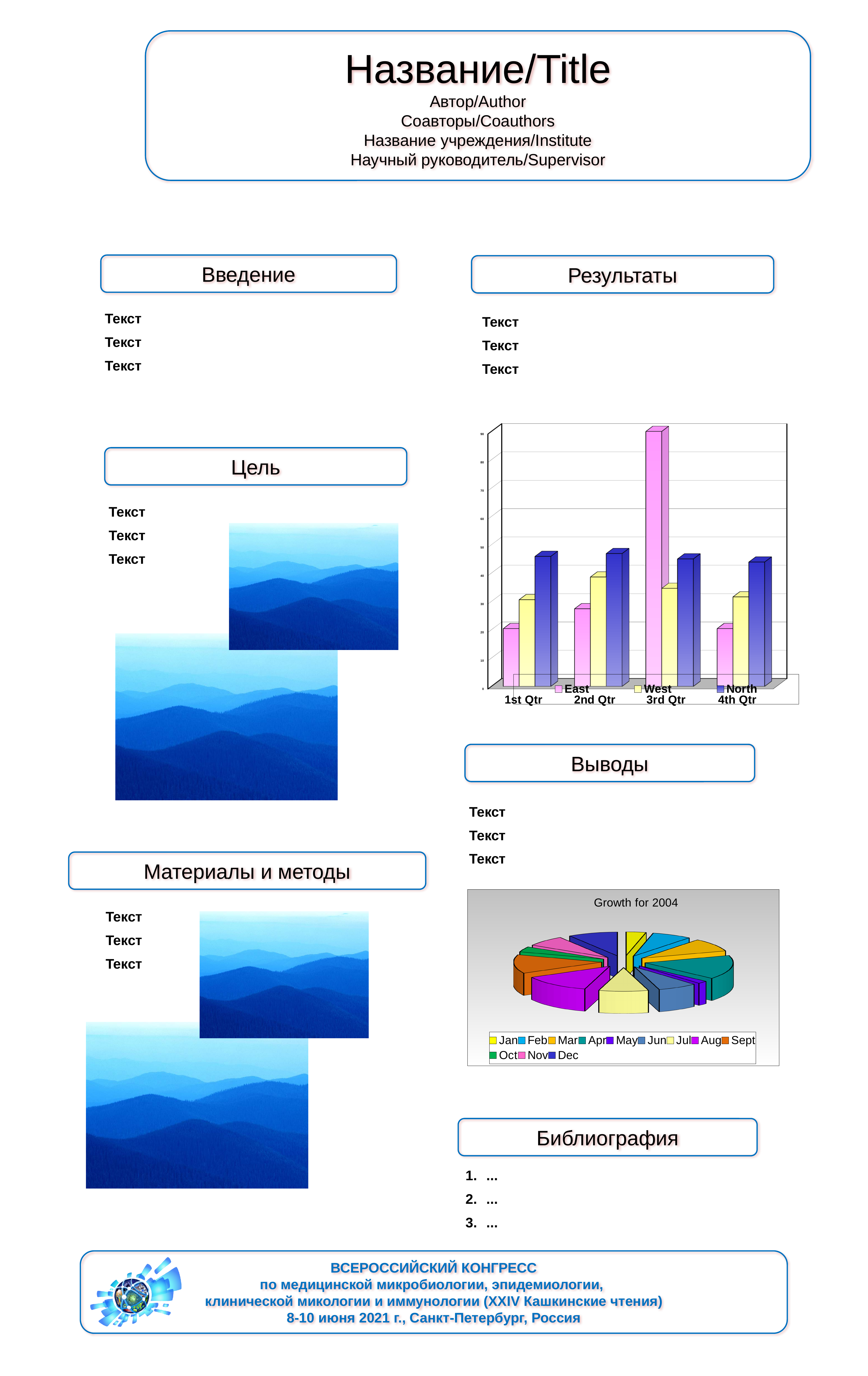
In the bar chart in the Результаты section, is the value for East in 1st Qtr greater or less than 30? less How many slices does the pie chart titled 'Growth for 2004' have? 12 In the bar chart in the Результаты section, is the value for North in 1st Qtr greater or less than 40? greater In the bar chart in the Результаты section, how many series does the legend list? 3 What is the title of the pie chart in the Выводы section? Growth for 2004 In the bar chart in the Результаты section, in which quarter is the East series highest? 3rd Qtr In the bar chart in the Результаты section, which is larger in 3rd Qtr: East or West? East What kind of chart is the chart titled 'Growth for 2004'? pie chart What kind of chart is the chart in the Результаты section (the upper chart on the right)? bar chart In the bar chart in the Результаты section, is the value for East in 3rd Qtr greater or less than 80? greater In the bar chart in the Результаты section, how many quarter categories are shown on the x axis? 4 In the bar chart in the Результаты section, which is larger in 1st Qtr: North or East? North